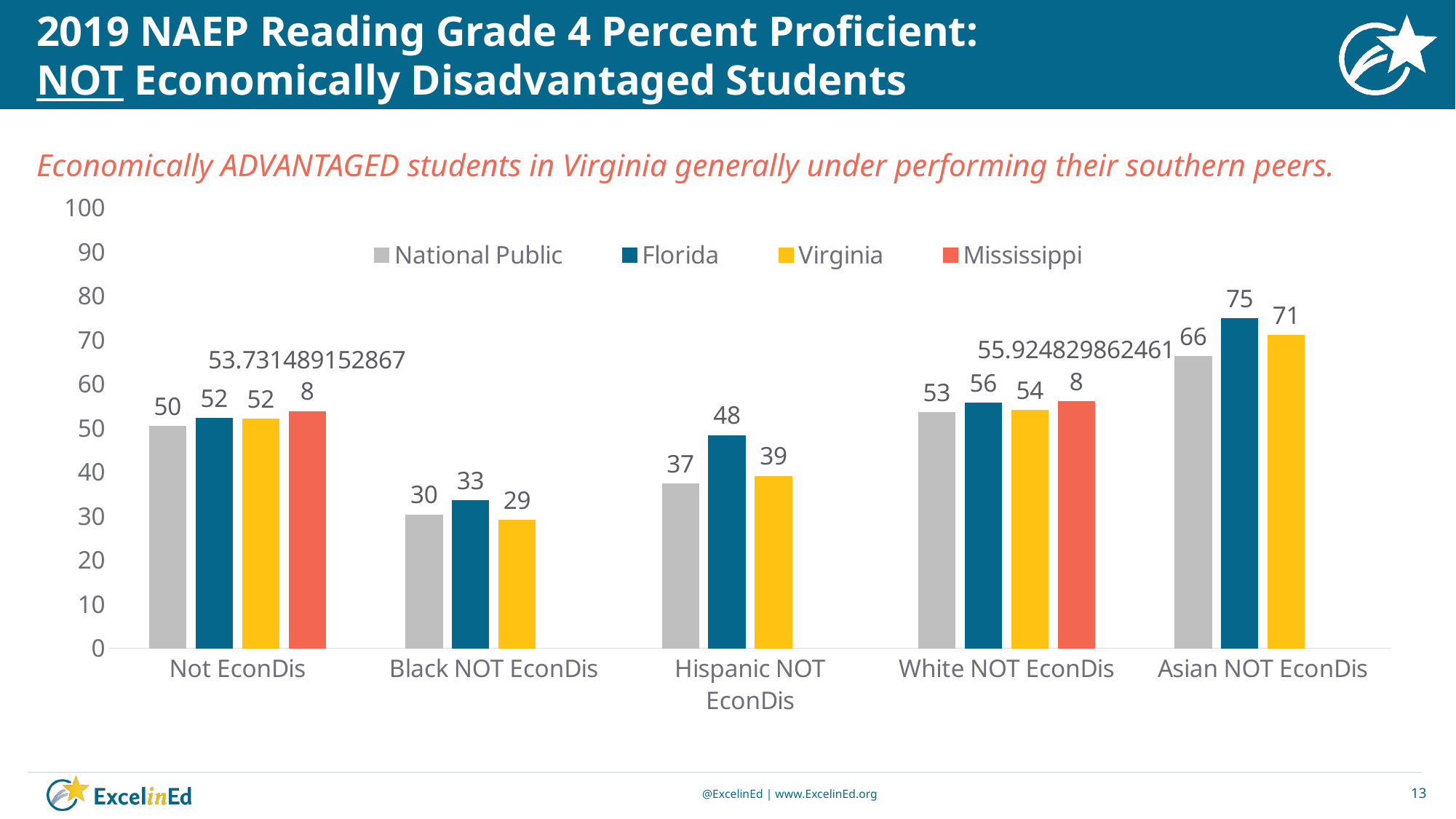
What is the value for Florida in the Asian NOT EconDis category? 75 What is the value for Virginia in the Black NOT EconDis category? 29 Is the value for Mississippi in the Not EconDis category greater or less than 50? greater How many series does the legend list? 4 In which category does Virginia have its lowest value? Black NOT EconDis Which series has no bar in the Black NOT EconDis category? Mississippi In which category does Florida have its highest value? Asian NOT EconDis What is the value for National Public in the Hispanic NOT EconDis category? 37 In the Hispanic NOT EconDis category, how much higher is Florida's value than Virginia's? 9 How many categories are shown on the x axis? 5 What kind of chart is shown on the slide? bar chart In the Asian NOT EconDis category, which is larger: Virginia or National Public? Virginia